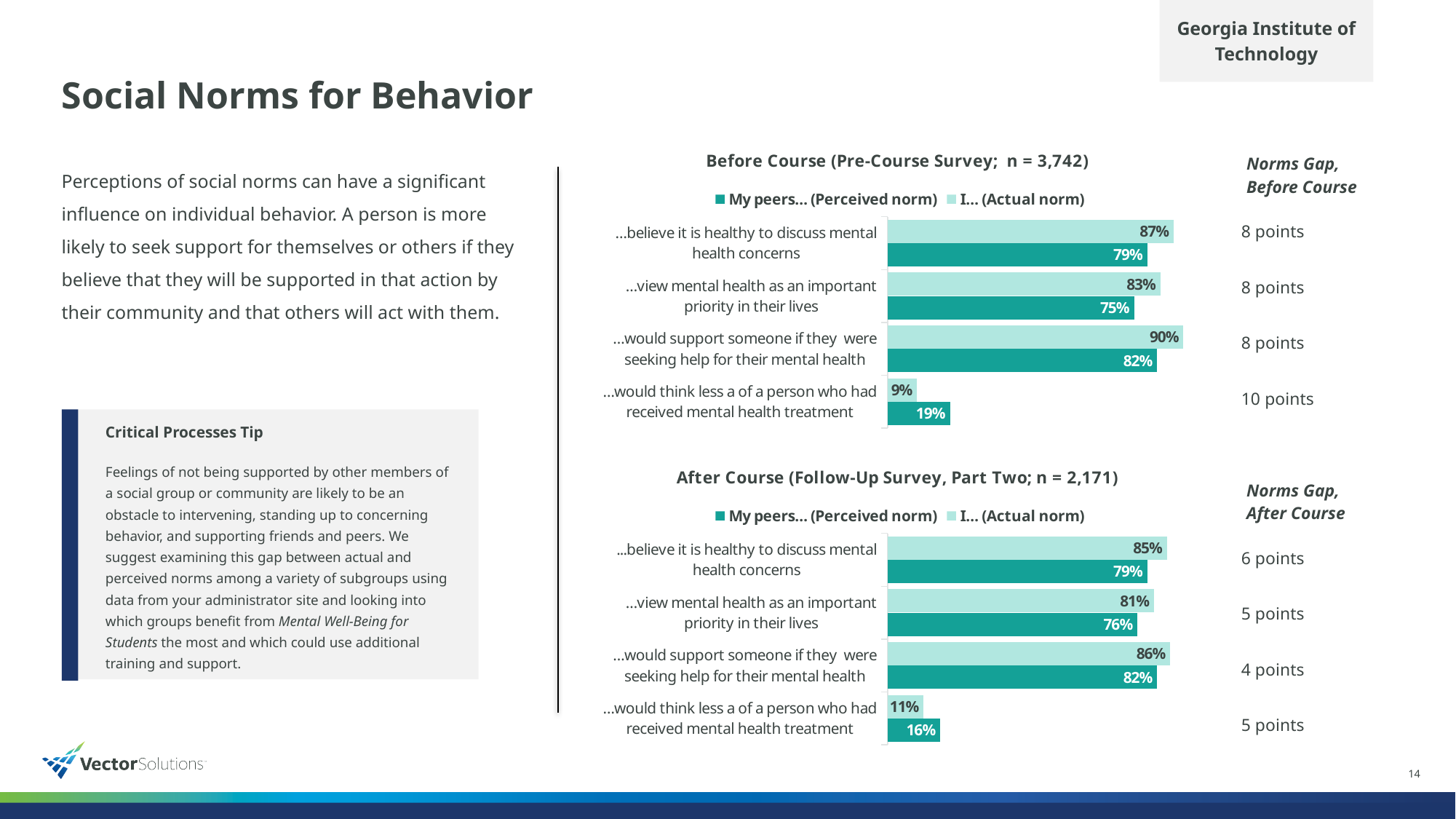
In the 'Before Course' chart, what is the value for 'My peers... (Perceived norm)' for '...would think less a of a person who had received mental health treatment'? 19% In the 'After Course' chart, what is the value for 'I... (Actual norm)' for '...would support someone if they were seeking help for their mental health'? 86% In the 'Before Course' chart, what is the difference between the 'I... (Actual norm)' and 'My peers... (Perceived norm)' values for '...view mental health as an important priority in their lives'? 8% How many categories does the 'Before Course' chart show? 4 How many series does the legend of the 'After Course' chart list? 2 In the 'Before Course' chart, which category has the highest 'I... (Actual norm)' value? ...would support someone if they were seeking help for their mental health In the 'Before Course' chart, what is the value for 'I... (Actual norm)' for '...believe it is healthy to discuss mental health concerns'? 87% What kind of chart is the 'Before Course' chart? Bar chart What is the sample size (n) stated in the title of the 'After Course' chart? 2,171 In the 'After Course' chart, what is the value for 'My peers... (Perceived norm)' for '...view mental health as an important priority in their lives'? 76% In the 'After Course' chart, which is larger for '...would think less a of a person who had received mental health treatment': 'My peers... (Perceived norm)' or 'I... (Actual norm)'? My peers... (Perceived norm) In the 'After Course' chart, which category has the lowest 'My peers... (Perceived norm)' value? ...would think less a of a person who had received mental health treatment